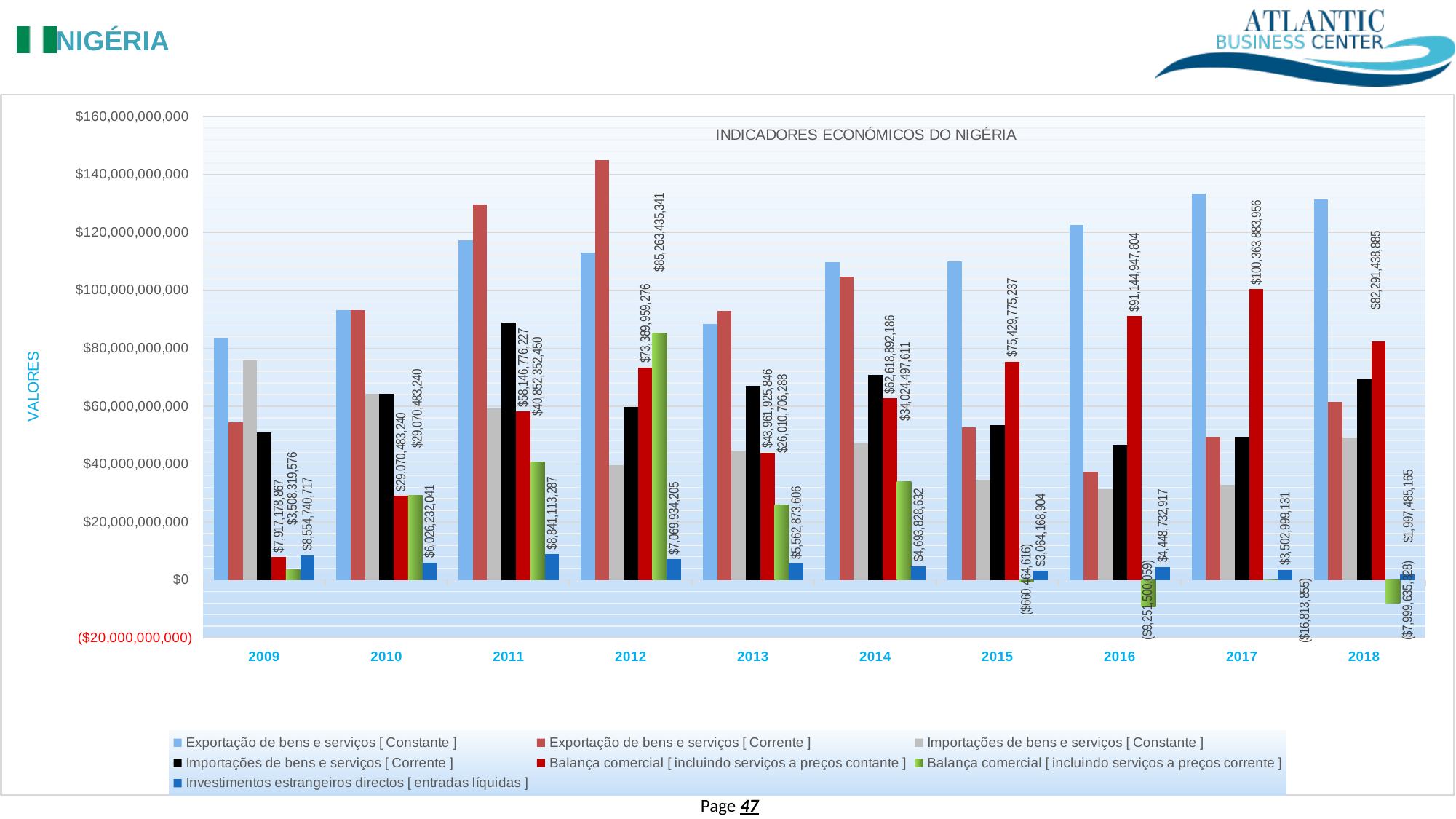
What is the value of Investimentos estrangeiros directos [entradas líquidas] in 2009? $8,554,740,717 What is the value of Balança comercial [incluindo serviços a preços corrente] in 2016? ($9,251,500,059) In which year is Balança comercial [incluindo serviços a preços contante] highest? 2017 What is the title of the chart? INDICADORES ECONÓMICOS DO NIGÉRIA In 2012, which is larger: Balança comercial [incluindo serviços a preços contante] or Balança comercial [incluindo serviços a preços corrente]? Balança comercial [incluindo serviços a preços corrente] How many years are shown on the x axis of the chart? 10 What is the difference between Balança comercial [incluindo serviços a preços contante] in 2017 and in 2016? $9,218,936,152 How many series does the chart legend list? 7 In which year is Investimentos estrangeiros directos [entradas líquidas] lowest? 2018 What kind of chart is shown on the slide? Bar chart Is the value of Exportação de bens e serviços [Constante] in 2017 greater or less than $120,000,000,000? greater What is the value of Balança comercial [incluindo serviços a preços contante] in 2017? $100,363,883,956